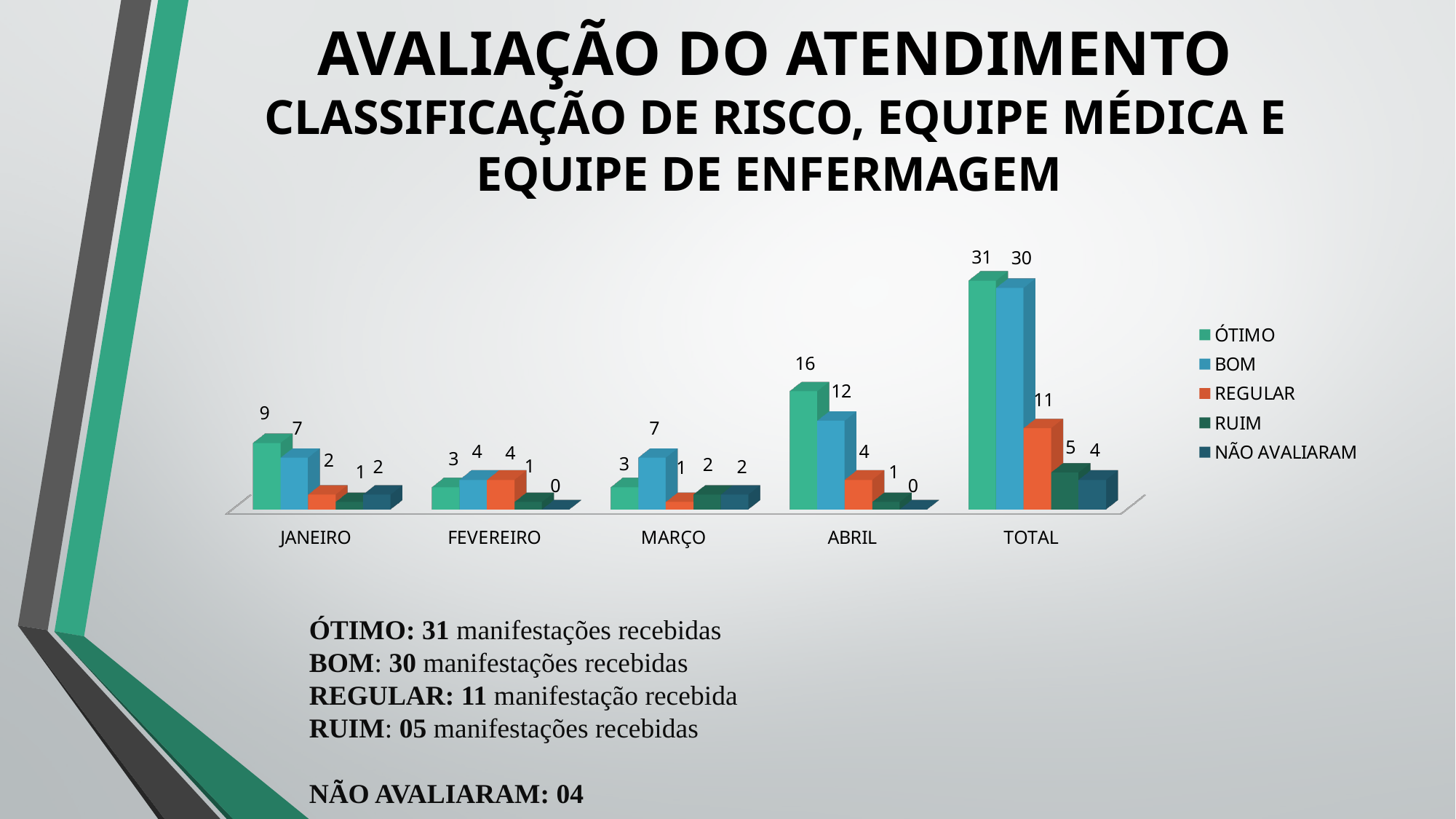
What is the value for ÓTIMO in ABRIL? 16 How many series does the legend list? 5 What is the value for BOM in JANEIRO? 7 Which is larger in MARÇO, the value for ÓTIMO or the value for BOM? BOM What is the value for REGULAR in TOTAL? 11 What type of chart is shown on the slide? bar chart Which series has the lowest value in the TOTAL category? NÃO AVALIARAM What is the value for NÃO AVALIARAM in FEVEREIRO? 0 Which series is shown in orange in the legend? REGULAR How many categories are shown on the x axis? 5 What is the difference between the ÓTIMO and BOM values in ABRIL? 4 In which month (excluding TOTAL) is the ÓTIMO value highest? ABRIL